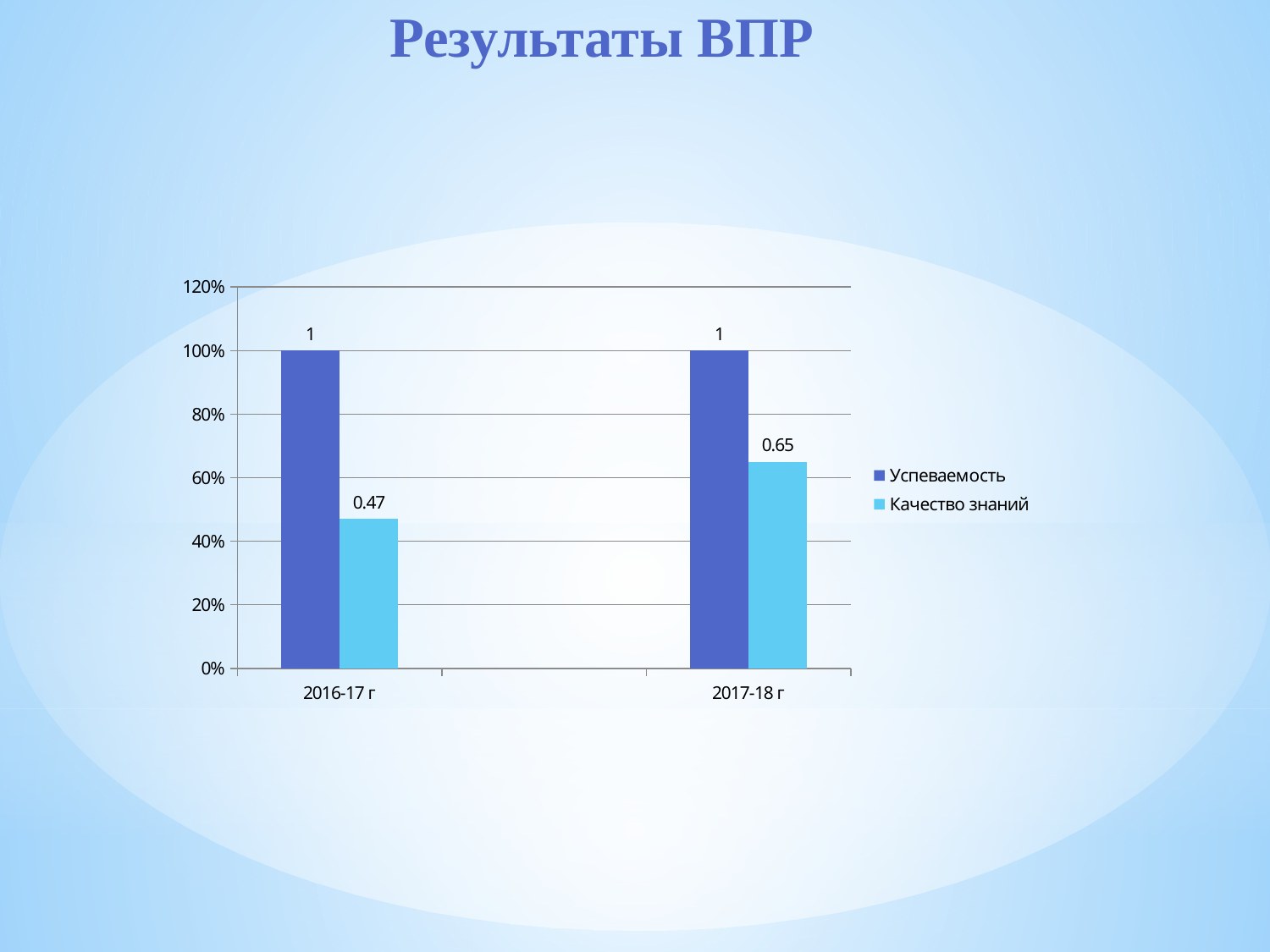
What is the value of Успеваемость for 2016-17 г? 1 In which year is Качество знаний higher? 2017-18 г How many categories are shown on the x axis? 2 What is the difference between Качество знаний in 2017-18 г and 2016-17 г? 0.18 Is the value of Качество знаний for 2017-18 г greater or less than 60%? greater What kind of chart is shown on the slide? bar chart Which is larger for 2016-17 г: Успеваемость or Качество знаний? Успеваемость How many series does the legend list? 2 What is the value of Качество знаний for 2017-18 г? 0.65 In which year is Качество знаний lowest? 2016-17 г What is the value of Качество знаний for 2016-17 г? 0.47 What is the value of Успеваемость for 2017-18 г? 1